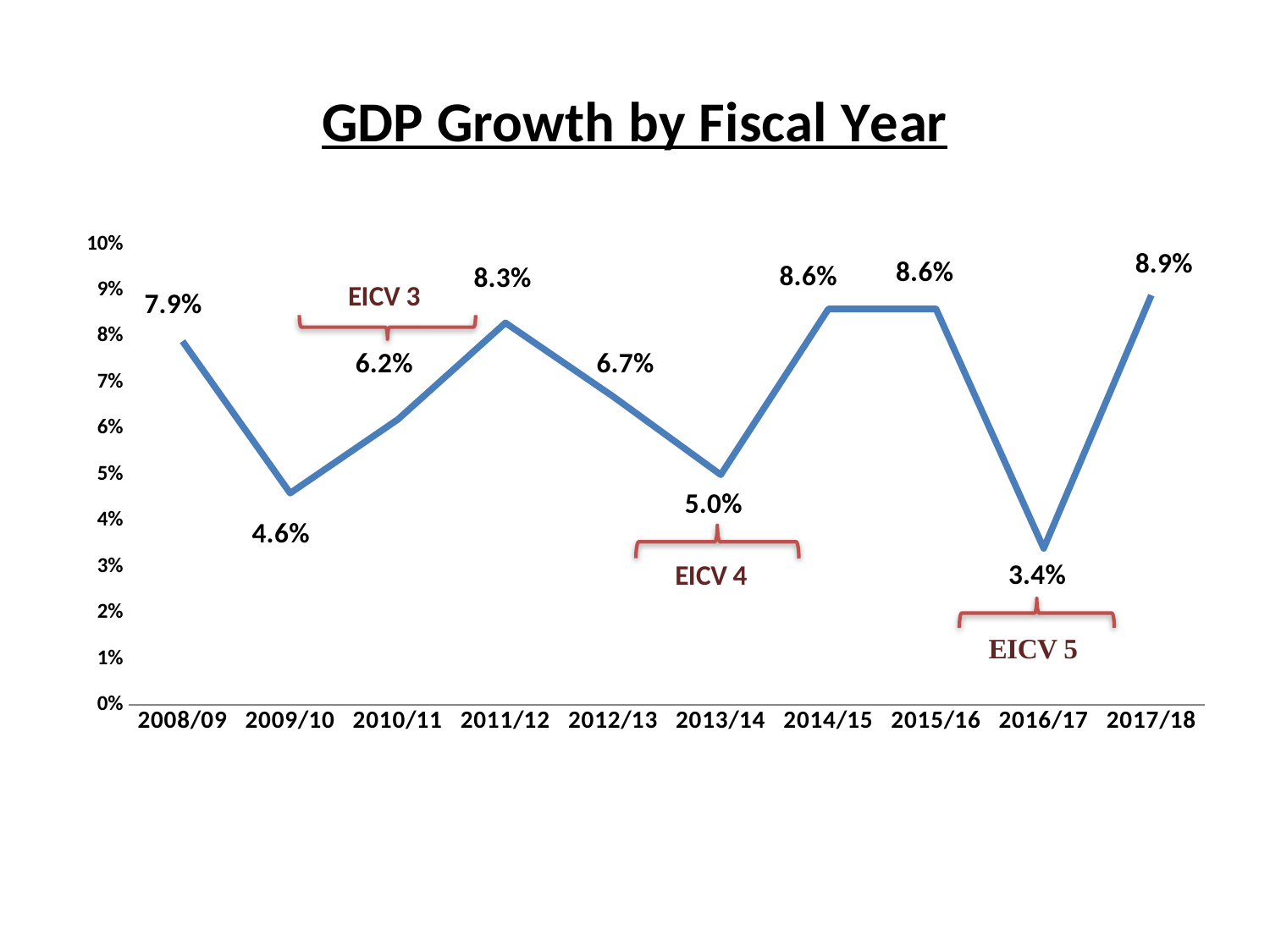
Which fiscal year has the highest GDP growth? 2017/18 Is the GDP growth value for 2009/10 greater or less than 5%? less What kind of chart is shown on the slide? line chart What is the GDP growth value for 2013/14? 5.0% What is the title of the chart? GDP Growth by Fiscal Year What is the GDP growth value for 2016/17? 3.4% What is the GDP growth value for 2008/09? 7.9% Which fiscal year has the lowest GDP growth? 2016/17 Does GDP growth rise or fall from 2009/10 to 2011/12? rise What is the difference between the GDP growth in 2017/18 and 2016/17? 5.5% Which is larger, the GDP growth in 2011/12 or in 2012/13? 2011/12 How many fiscal years are plotted on the chart? 10